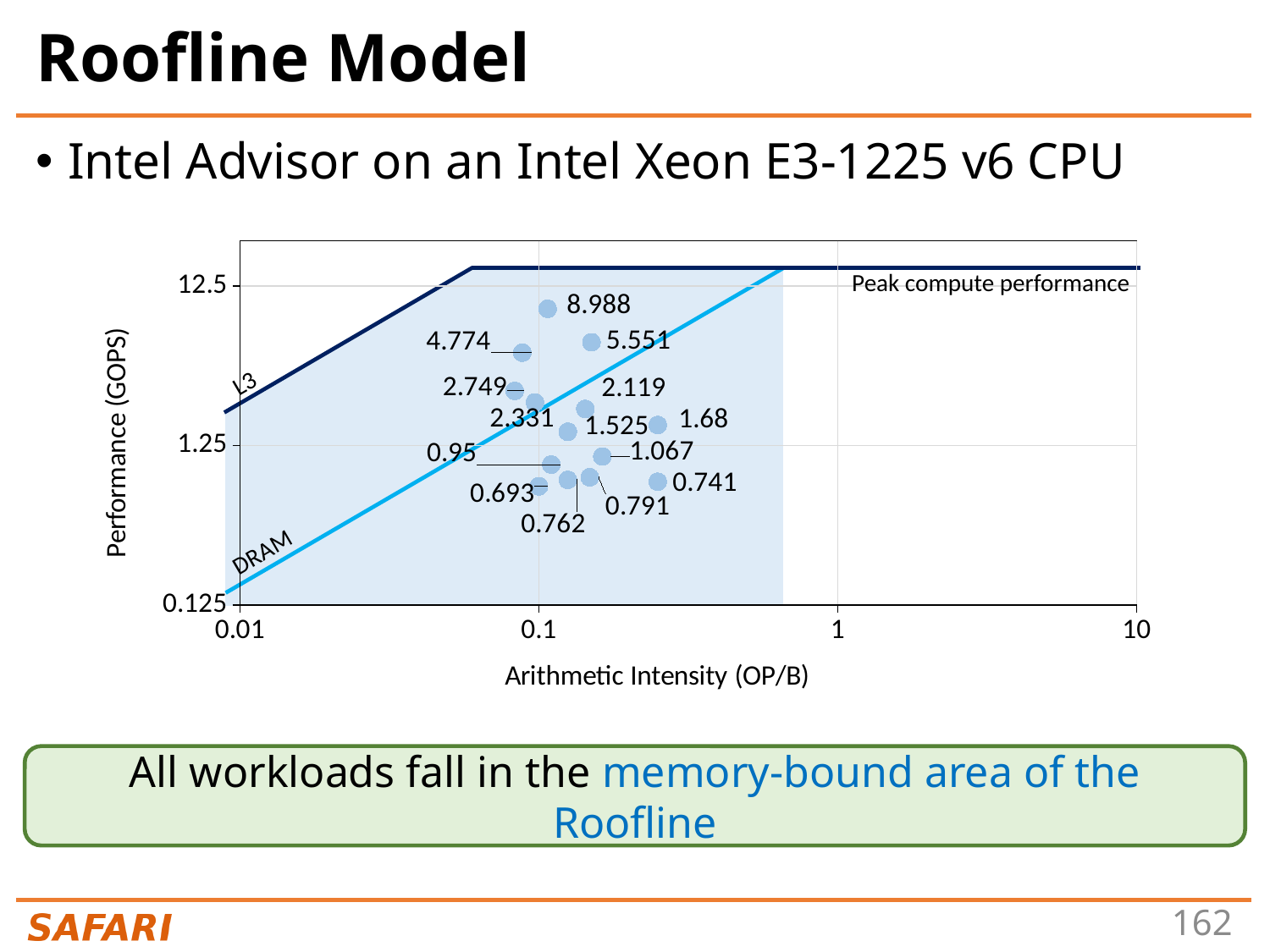
What is the label of the x axis? Arithmetic Intensity (OP/B) How many labelled workload points are plotted on the chart? 14 What are the tick values shown on the x axis? 0.01, 0.1, 1, 10 What is the difference between the highest labelled value (8.988) and the lowest labelled value (0.693)? 8.295 What is the label of the y axis? Performance (GOPS) Is the highest plotted workload point (8.988) greater or less than 12.5 GOPS? less Is the workload point labelled 0.741 greater or less than 1.25 GOPS? less What is the highest performance value labelled among the plotted workload points? 8.988 What is the difference between the labelled values 2.749 and 2.331? 0.418 What is the lowest performance value labelled among the plotted workload points? 0.693 What kind of chart is shown on the slide? Scatter chart Which labelled value is larger, 5.551 or 4.774? 5.551